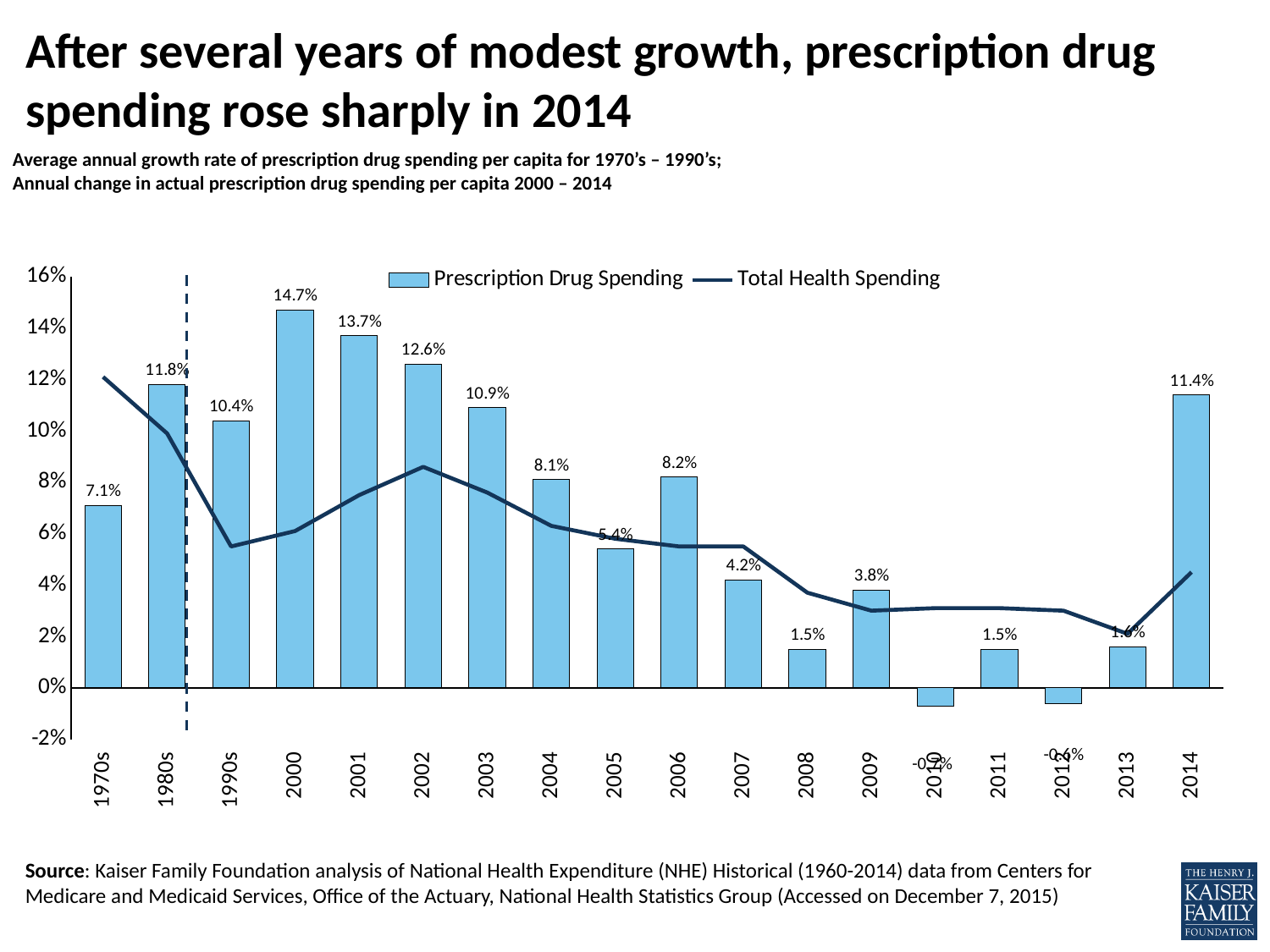
What is the Prescription Drug Spending value for 2008? 1.5% Which is larger, the Prescription Drug Spending value for 2002 or for 2003? 2002 What is the difference between the Prescription Drug Spending values for 2000 and 2001? 1.0% How many series does the legend list? 2 What is the Prescription Drug Spending value for 2014? 11.4% How many categories are shown on the x axis? 18 Is the Total Health Spending value for 2010 greater or less than 4%? less Which category has the highest Prescription Drug Spending bar? 2000 What is the Prescription Drug Spending value for the 1970s? 7.1% What is the difference between the Prescription Drug Spending values for 2014 and 2011? 9.9% Is the Total Health Spending value for the 1970s greater or less than 10%? greater What is the Prescription Drug Spending value for 2000? 14.7%